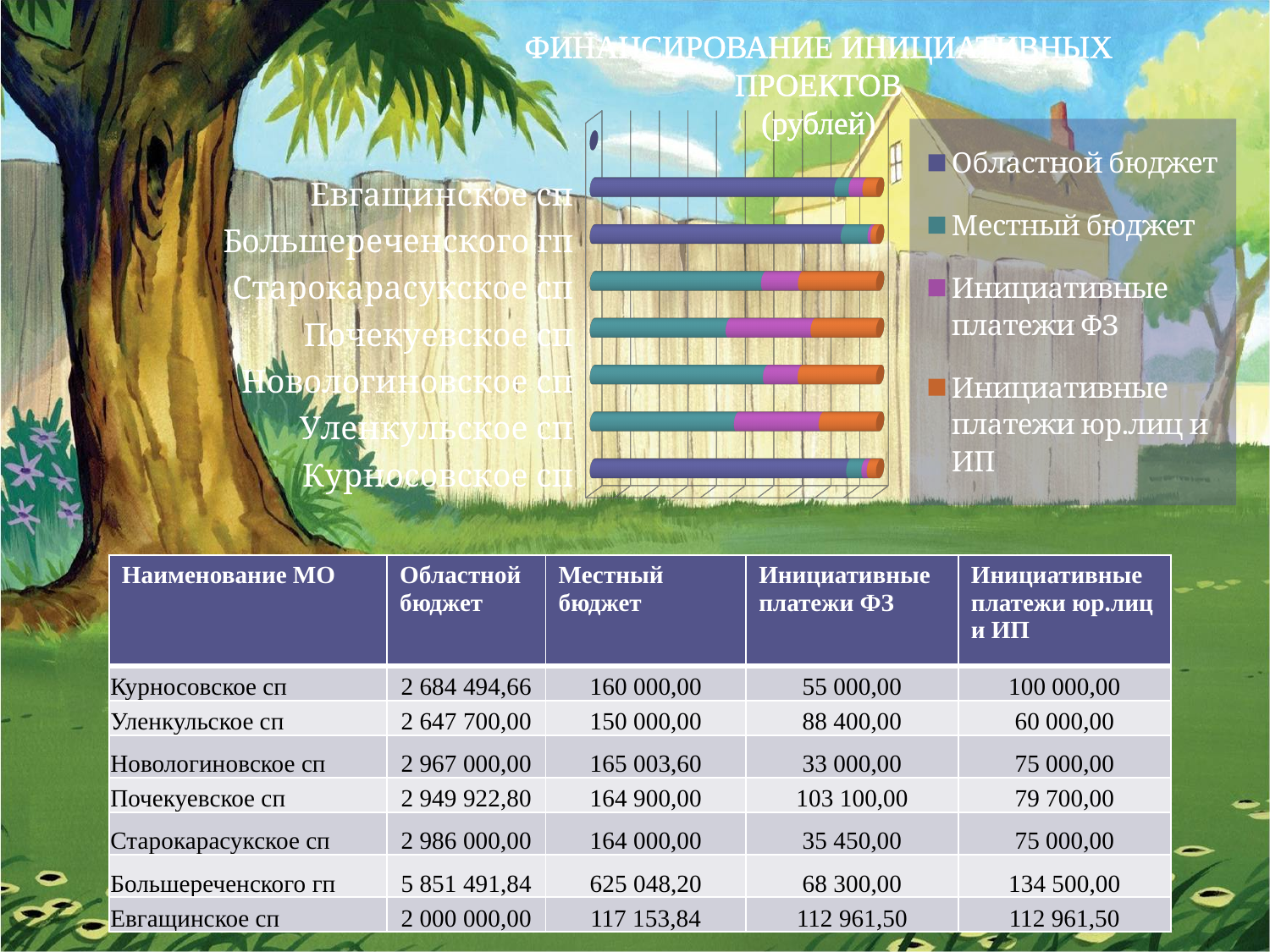
What kind of chart is shown on the slide? Stacked bar chart What is the value of Областной бюджет for Большереченского гп? 5 851 491,84 What is the value of Инициативные платежи ФЗ for Почекуевское сп? 103 100,00 How many series does the chart legend list? 4 What is the title of the chart? ФИНАНСИРОВАНИЕ ИНИЦИАТИВНЫХ ПРОЕКТОВ (рублей) Which is larger, the Инициативные платежи ФЗ value for Почекуевское сп or for Уленкульское сп? Почекуевское сп What is the difference between the Местный бюджет values for Курносовское сп and Уленкульское сп? 10 000,00 What is the value of Местный бюджет for Евгащинское сп? 117 153,84 How many categories (municipalities) are plotted on the chart? 7 Which legend entry is shown in orange? Инициативные платежи юр.лиц и ИП Which municipality has the highest Областной бюджет value? Большереченского гп